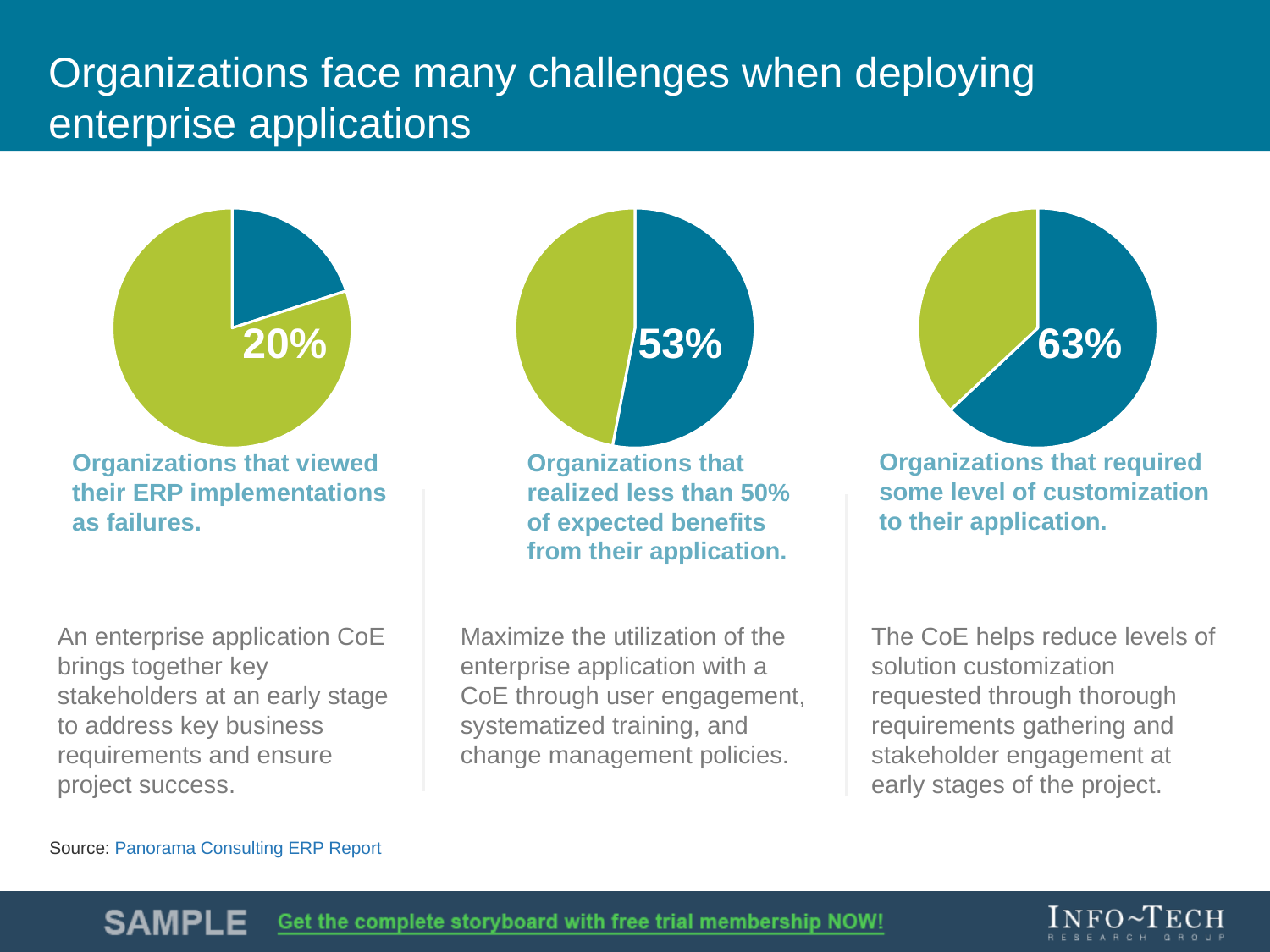
In the left pie chart, what share of the pie does the green slice represent? 80% In the left pie chart, what percentage of organizations viewed their ERP implementations as failures? 20% How many pie charts are on the slide? 3 How many slices does the left pie chart have? 2 Which is larger: the percentage in the middle pie chart or the percentage in the left pie chart? The middle pie chart (53%) In each pie chart, which colour is used for the slice whose percentage is printed? Blue Which of the three pie charts shows the highest highlighted percentage? The right pie chart (63%) What kind of charts are shown on the slide? Pie charts In the right pie chart, what percentage of organizations required some level of customization to their application? 63% Which of the three pie charts shows the lowest highlighted percentage? The left pie chart (20%) In the middle pie chart, what percentage of organizations realized less than 50% of expected benefits from their application? 53% What is the difference between the percentage in the right pie chart and the percentage in the left pie chart? 43 percentage points